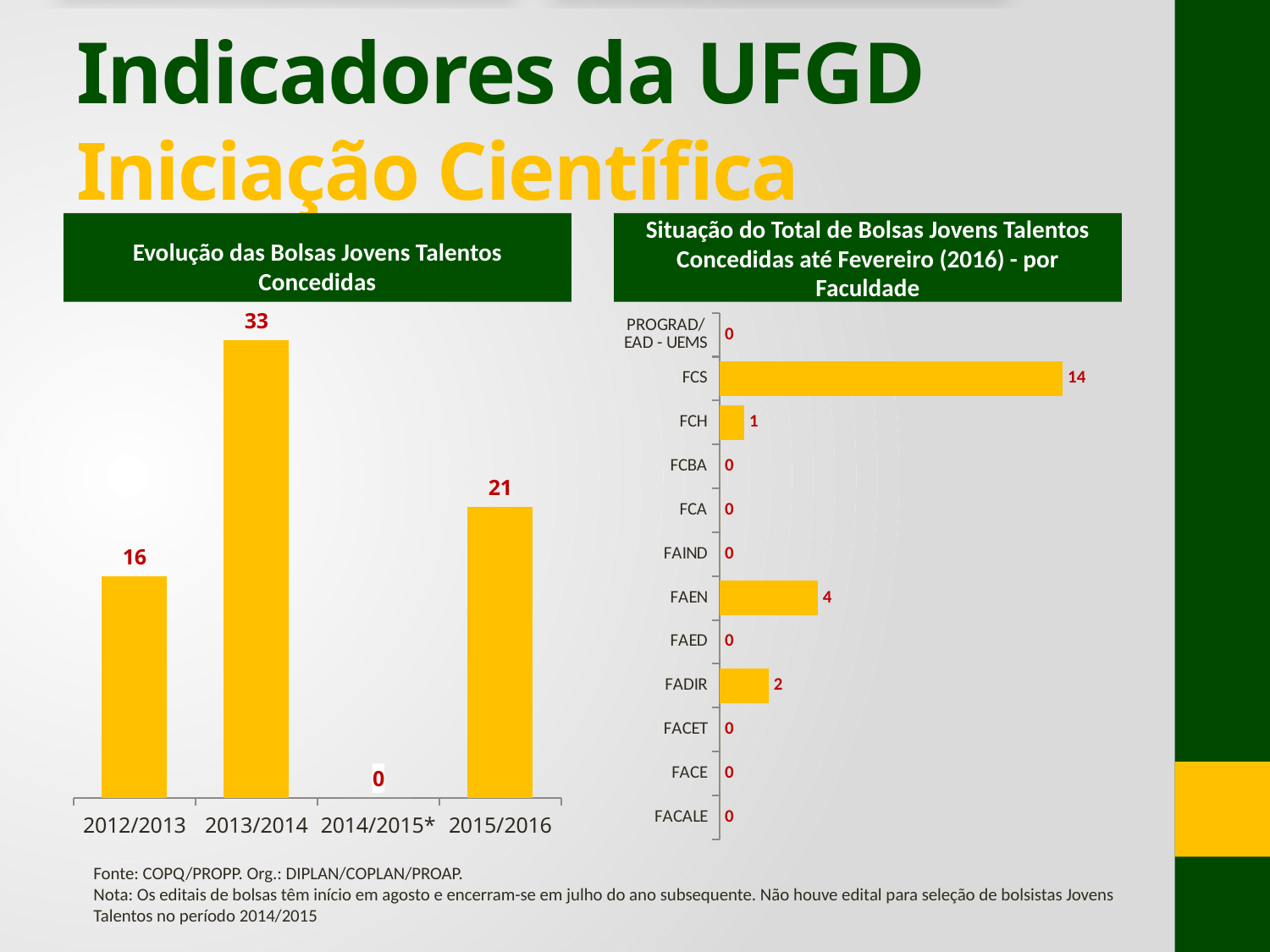
In the chart 'Situação do Total de Bolsas Jovens Talentos Concedidas até Fevereiro (2016) - por Faculdade', how many faculties are listed? 12 In the chart 'Situação do Total de Bolsas Jovens Talentos Concedidas até Fevereiro (2016) - por Faculdade', what colour are the bars? Yellow In the chart 'Evolução das Bolsas Jovens Talentos Concedidas', what is the value for 2013/2014? 33 In the chart 'Situação do Total de Bolsas Jovens Talentos Concedidas até Fevereiro (2016) - por Faculdade', which faculty has the highest value? FCS In the chart 'Evolução das Bolsas Jovens Talentos Concedidas', what is the difference between the values for 2013/2014 and 2015/2016? 12 In the chart 'Evolução das Bolsas Jovens Talentos Concedidas', which period has the lowest value? 2014/2015* What type of chart is 'Evolução das Bolsas Jovens Talentos Concedidas'? Bar chart In the chart 'Situação do Total de Bolsas Jovens Talentos Concedidas até Fevereiro (2016) - por Faculdade', what is the difference between the values for FCS and FAEN? 10 In the chart 'Situação do Total de Bolsas Jovens Talentos Concedidas até Fevereiro (2016) - por Faculdade', what is the value for FAEN? 4 In the chart 'Evolução das Bolsas Jovens Talentos Concedidas', how many periods are shown on the x axis? 4 In the chart 'Evolução das Bolsas Jovens Talentos Concedidas', which period has the highest value? 2013/2014 In the chart 'Situação do Total de Bolsas Jovens Talentos Concedidas até Fevereiro (2016) - por Faculdade', which is larger, the value for FADIR or the value for FCH? FADIR